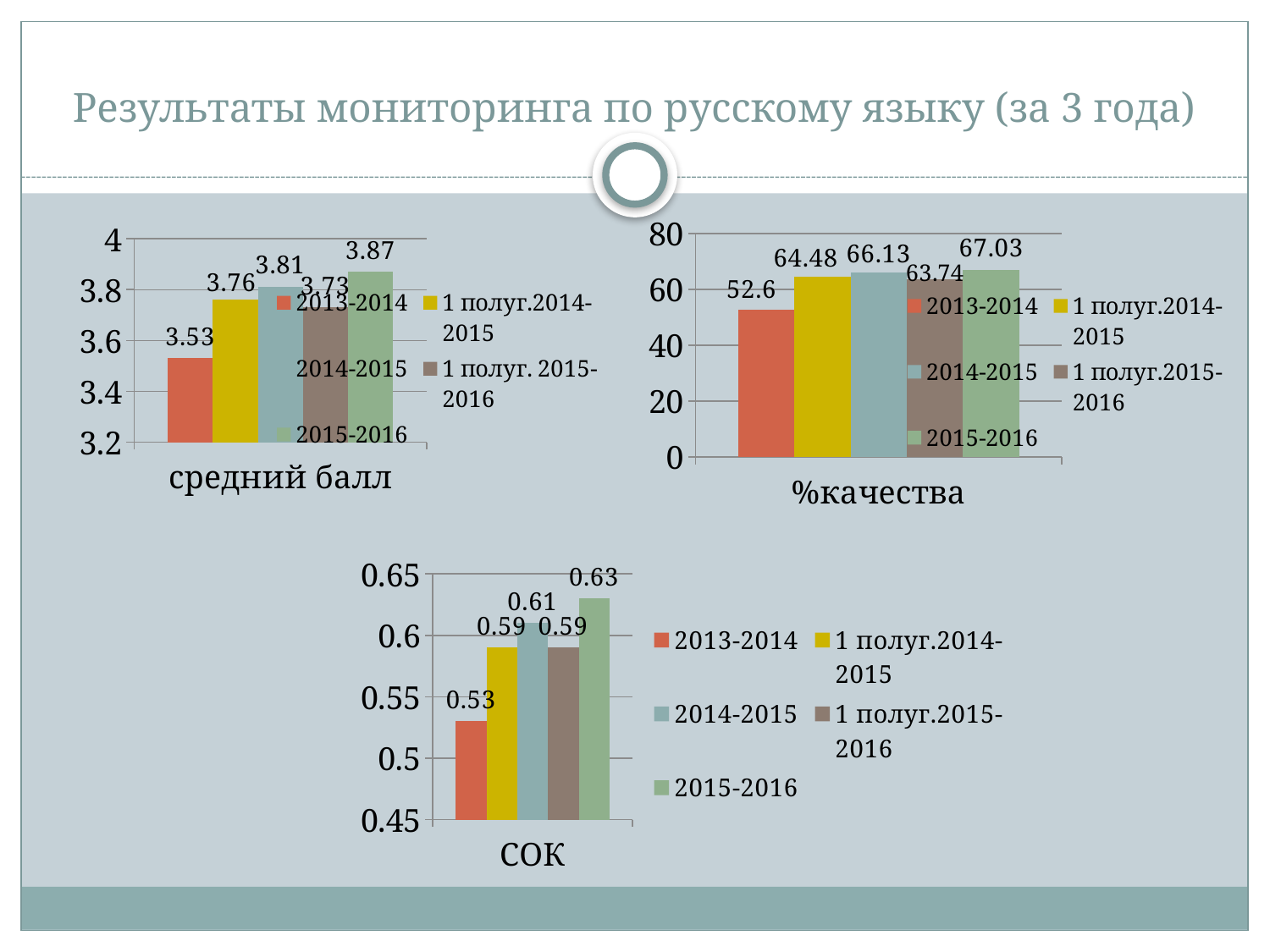
In the "%качества" chart, is the value for 2013-2014 greater or less than 60? less In the "%качества" chart, which series has the lowest value? 2013-2014 In the "средний балл" chart, what is the difference between the 2015-2016 value and the 2013-2014 value? 0.34 How many series does the legend of the "СОК" chart list? 5 In the "СОК" chart, what is the difference between the 2015-2016 value and the 2014-2015 value? 0.02 In the "средний балл" chart, what is the value for 2013-2014? 3.53 In the "%качества" chart, which is larger: the value for 2014-2015 or the value for 1 полуг.2014-2015? 2014-2015 In the "СОК" chart, what is the value for 2014-2015? 0.61 In the "средний балл" chart, which series has the highest value? 2015-2016 What kind of chart is the "средний балл" chart? bar chart How many charts are shown on the slide? 3 In the "%качества" chart, what is the value for 1 полуг.2015-2016? 63.74